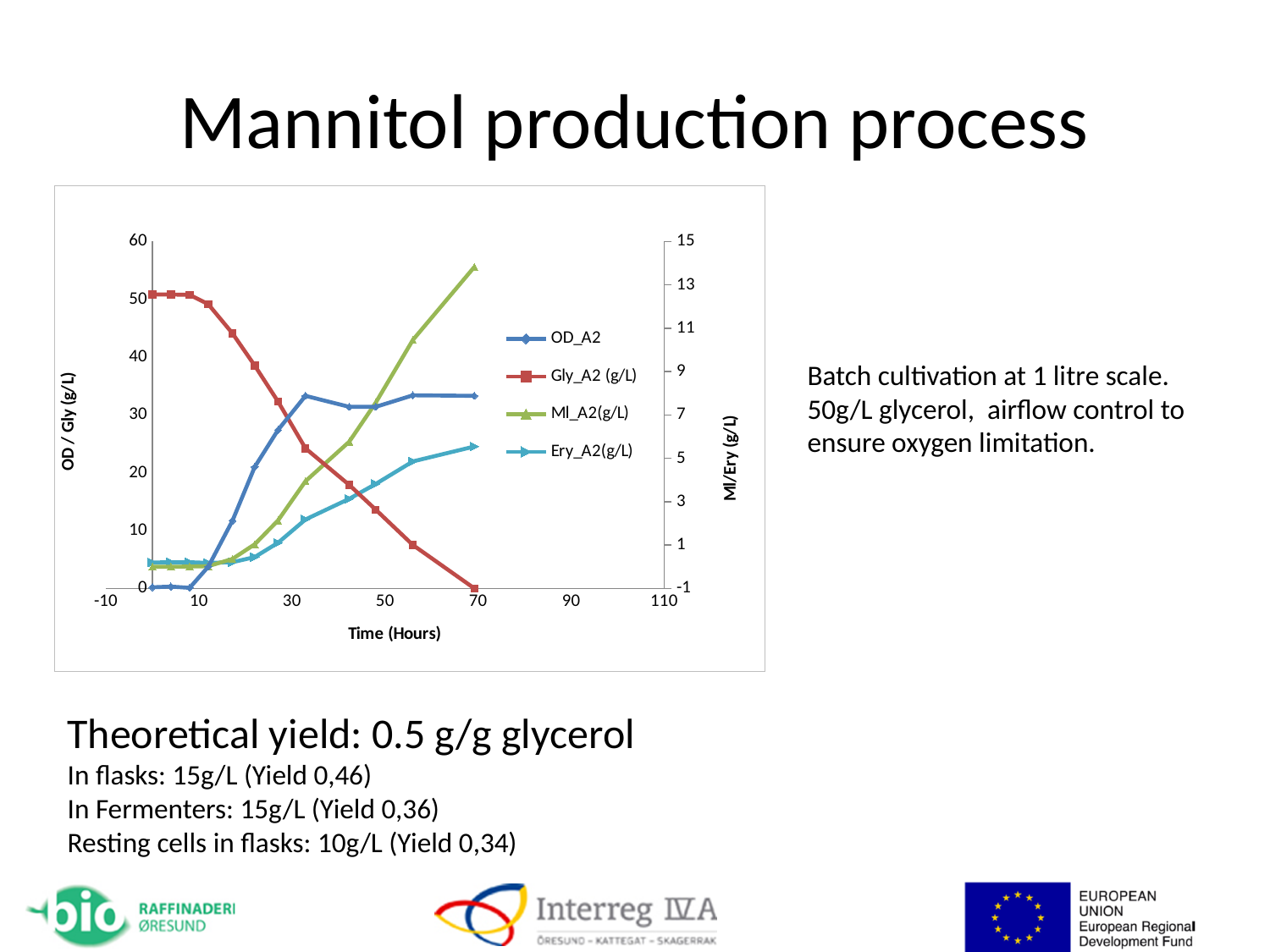
Is the value of Gly_A2 (g/L) at about 70 hours greater or less than 10 on the left axis? less How many series does the chart legend list? 4 Is the value of Ml_A2(g/L) at about 70 hours greater or less than 11 on the right axis? greater What kind of chart is shown on the slide? line chart Does the Ml_A2(g/L) series rise or fall as time increases? rise What are the series names listed in the chart legend? OD_A2, Gly_A2 (g/L), Ml_A2(g/L), Ery_A2(g/L) Does the Gly_A2 (g/L) series rise or fall as time increases? fall Is the value of Ery_A2(g/L) at about 70 hours greater or less than 7 on the right axis? less What is the title of the x axis of the chart? Time (Hours) At about 70 hours, which is larger on the right axis: Ml_A2(g/L) or Ery_A2(g/L)? Ml_A2(g/L)